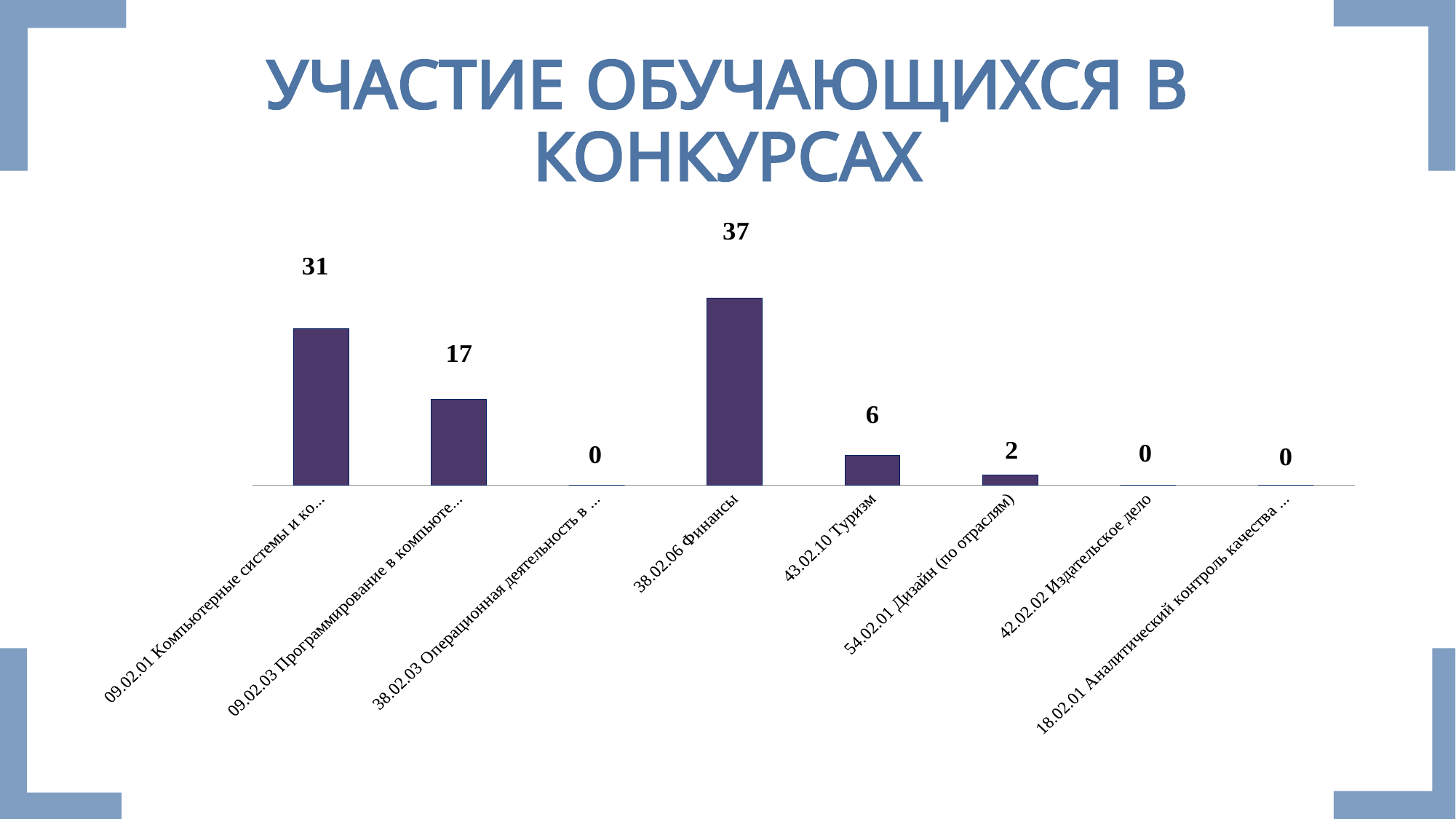
What is the value for 43.02.10 Туризм? 6 Which category has the highest value? 38.02.06 Финансы Which is larger, the value for 43.02.10 Туризм or the value for 54.02.01 Дизайн (по отраслям)? 43.02.10 Туризм What is the value for 38.02.06 Финансы? 37 What is the value for the category with code 09.02.03? 17 How many categories have a value of 0? 3 What is the value for 54.02.01 Дизайн (по отраслям)? 2 What kind of chart is shown on the slide? Bar chart What is the value for the category with code 09.02.01? 31 How many categories are shown on the x axis? 8 What is the difference between the values for 38.02.06 Финансы and the category with code 09.02.01? 6 What is the value for 42.02.02 Издательское дело? 0